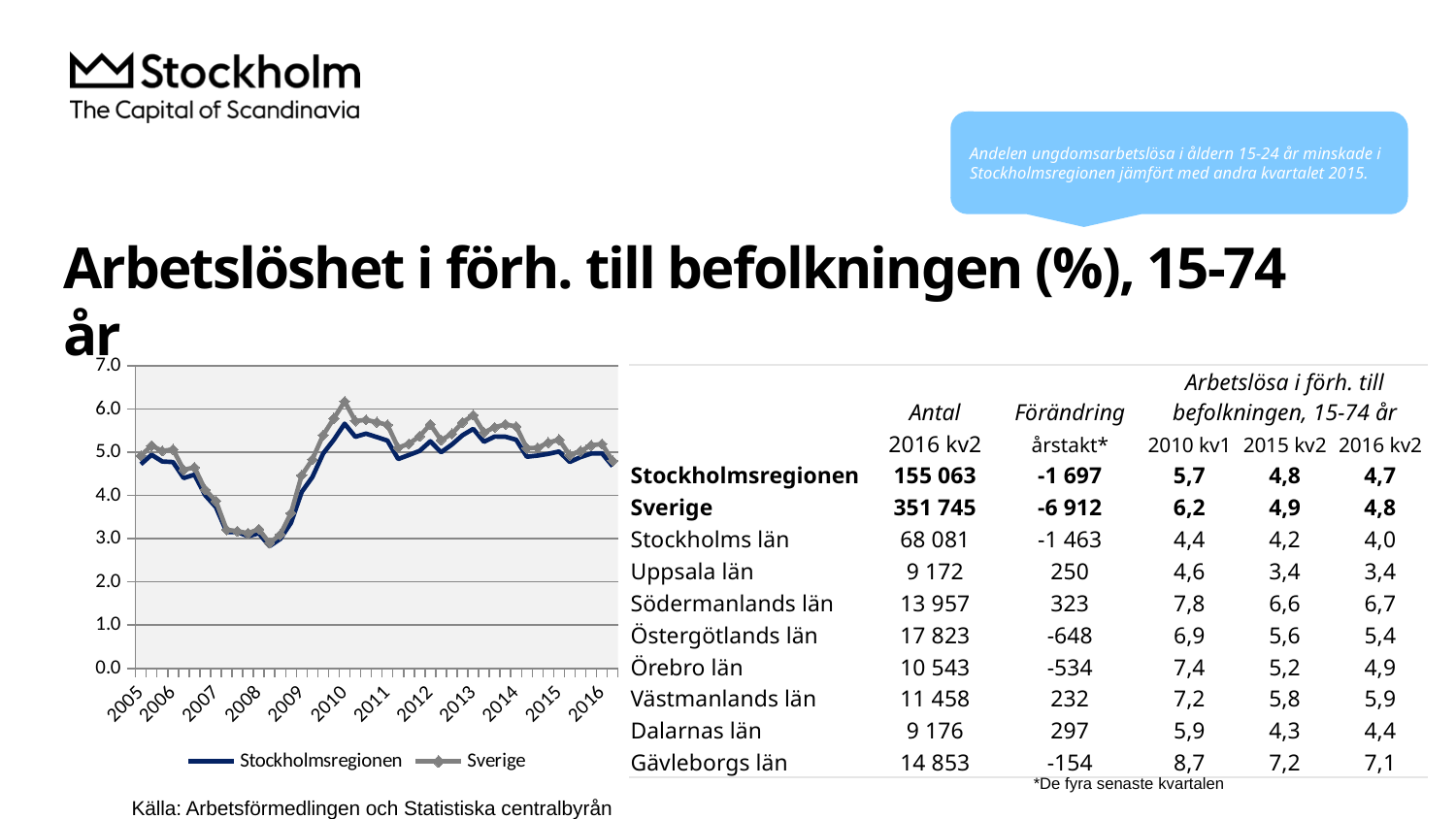
Is the value for Stockholmsregionen in 2016 greater or less than 6.0? less Is the value for Stockholmsregionen in 2008 greater or less than 4.0? less What is the highest value shown on the chart's y axis? 7.0 Around which year does the Sverige series reach its highest point? 2010 How many years are labelled along the x axis of the chart? 12 How many series does the chart's legend list? 2 Which series is higher in 2013, Stockholmsregionen or Sverige? Sverige What are the two series named in the chart's legend? Stockholmsregionen and Sverige What kind of chart is shown on the slide? line chart Do the values for Stockholmsregionen rise or fall between 2008 and 2010? rise Do the values for Sverige rise or fall between 2005 and 2008? fall Is the value for Sverige in 2010 greater or less than 5.0? greater